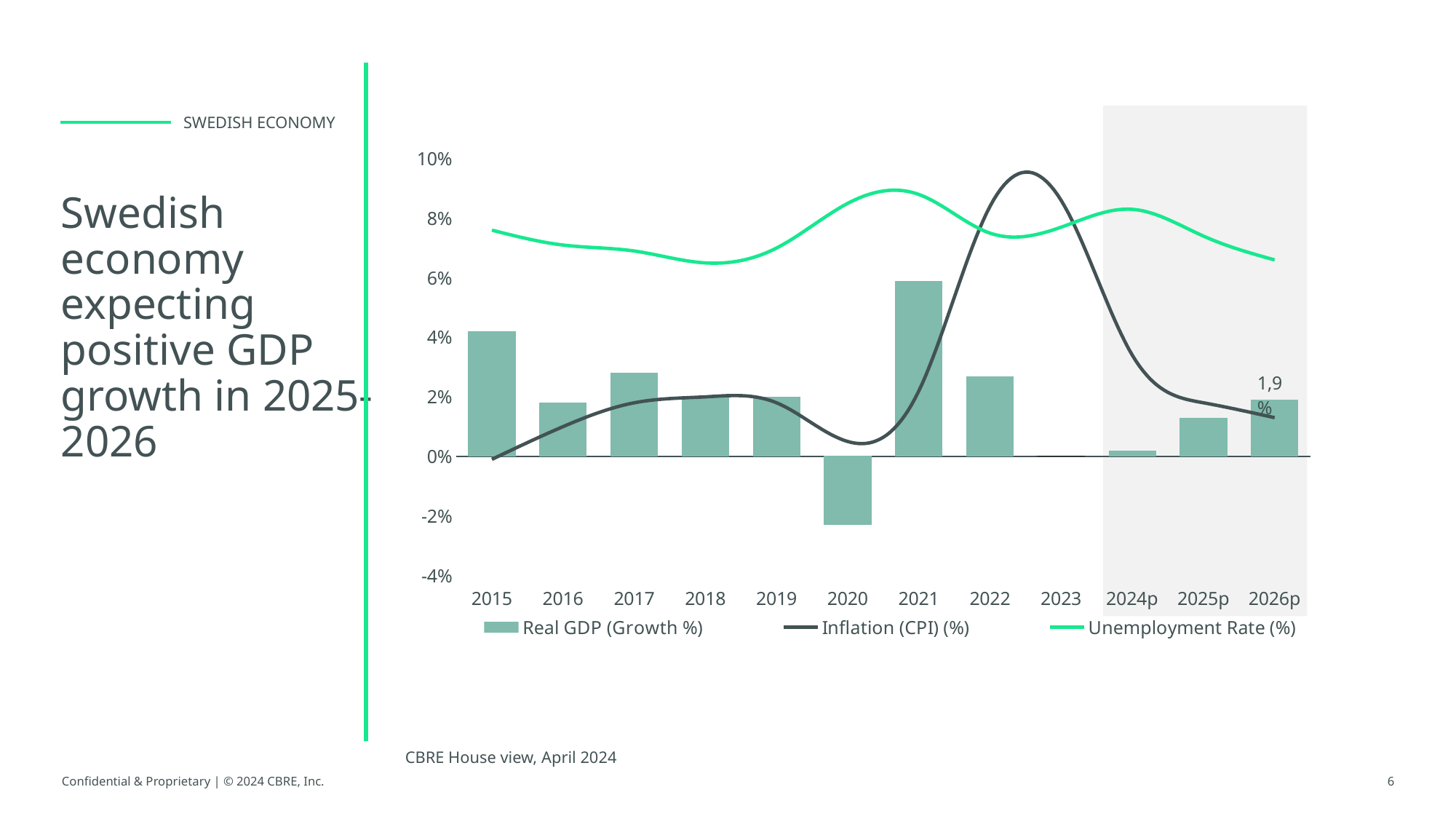
Does the Unemployment Rate (%) line rise or fall from 2024p to 2026p? fall Is the Unemployment Rate (%) value for 2015 greater or less than 6%? greater Is the Real GDP (Growth %) value for 2021 greater or less than 4%? greater What is the Real GDP (Growth %) value shown for 2026p? 1,9 % How many years (categories) are shown on the x axis of the chart? 12 Which series in the legend is drawn as bars? Real GDP (Growth %) In which year is the Real GDP (Growth %) bar the lowest? 2020 What kind of chart is shown on the slide? Combined bar and line chart How many series does the chart legend list? 3 Which year has the larger Real GDP (Growth %) bar, 2016 or 2017? 2017 In which year is the Real GDP (Growth %) bar the highest? 2021